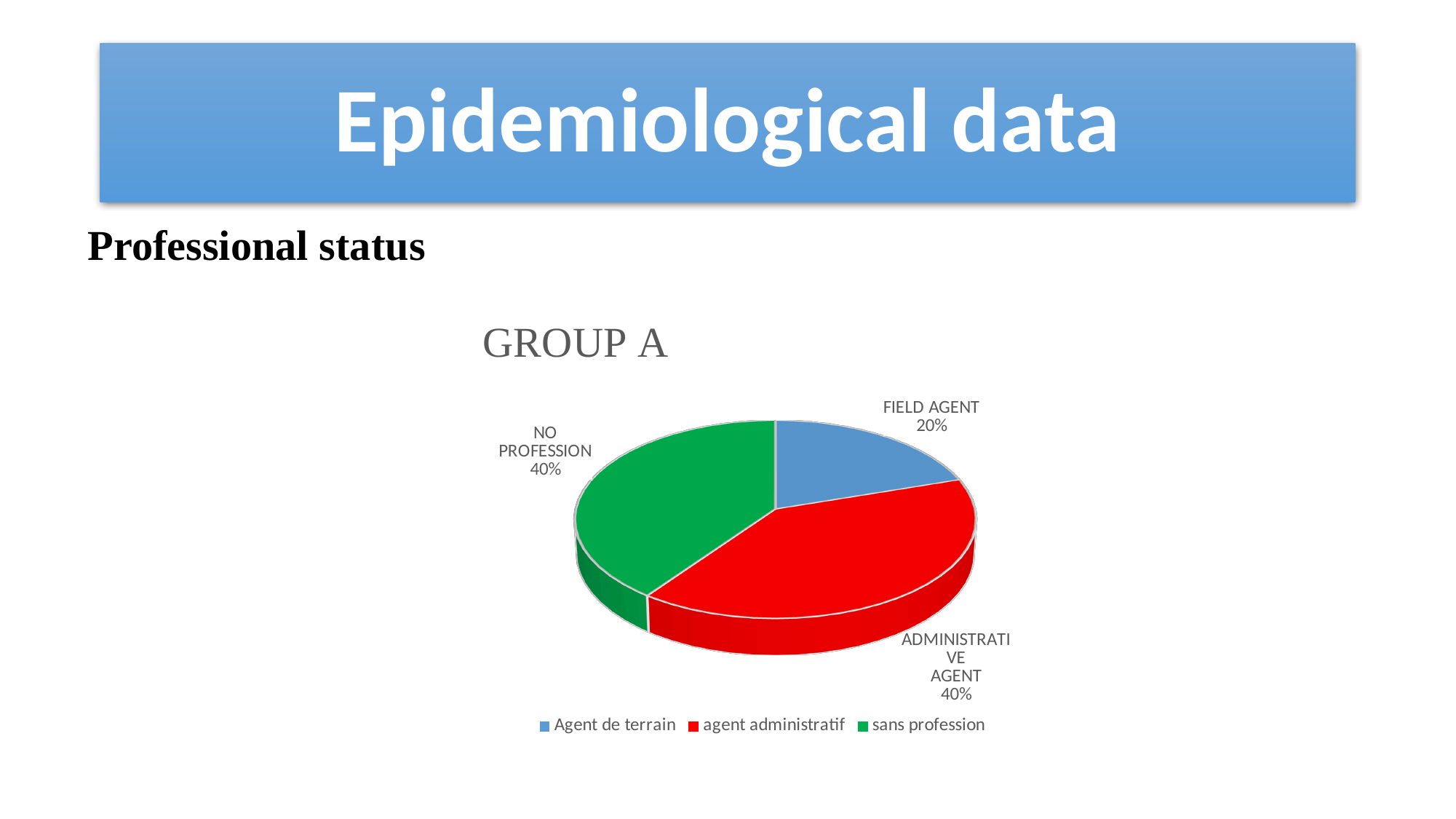
How many entries does the legend list? 3 Is the share for FIELD AGENT greater or less than 30%? less Which is larger, the share for ADMINISTRATIVE AGENT or the share for FIELD AGENT? ADMINISTRATIVE AGENT What share of the pie does NO PROFESSION represent? 40% What is the difference in percentage points between NO PROFESSION and FIELD AGENT? 20 Which category has the smallest slice of the pie? FIELD AGENT What share of the pie does FIELD AGENT represent? 20% How many slices does the pie chart have? 3 What type of chart is shown on the slide? pie chart What share of the pie does ADMINISTRATIVE AGENT represent? 40% What is the title of the chart? GROUP A Which colour represents 'sans profession' in the legend? green